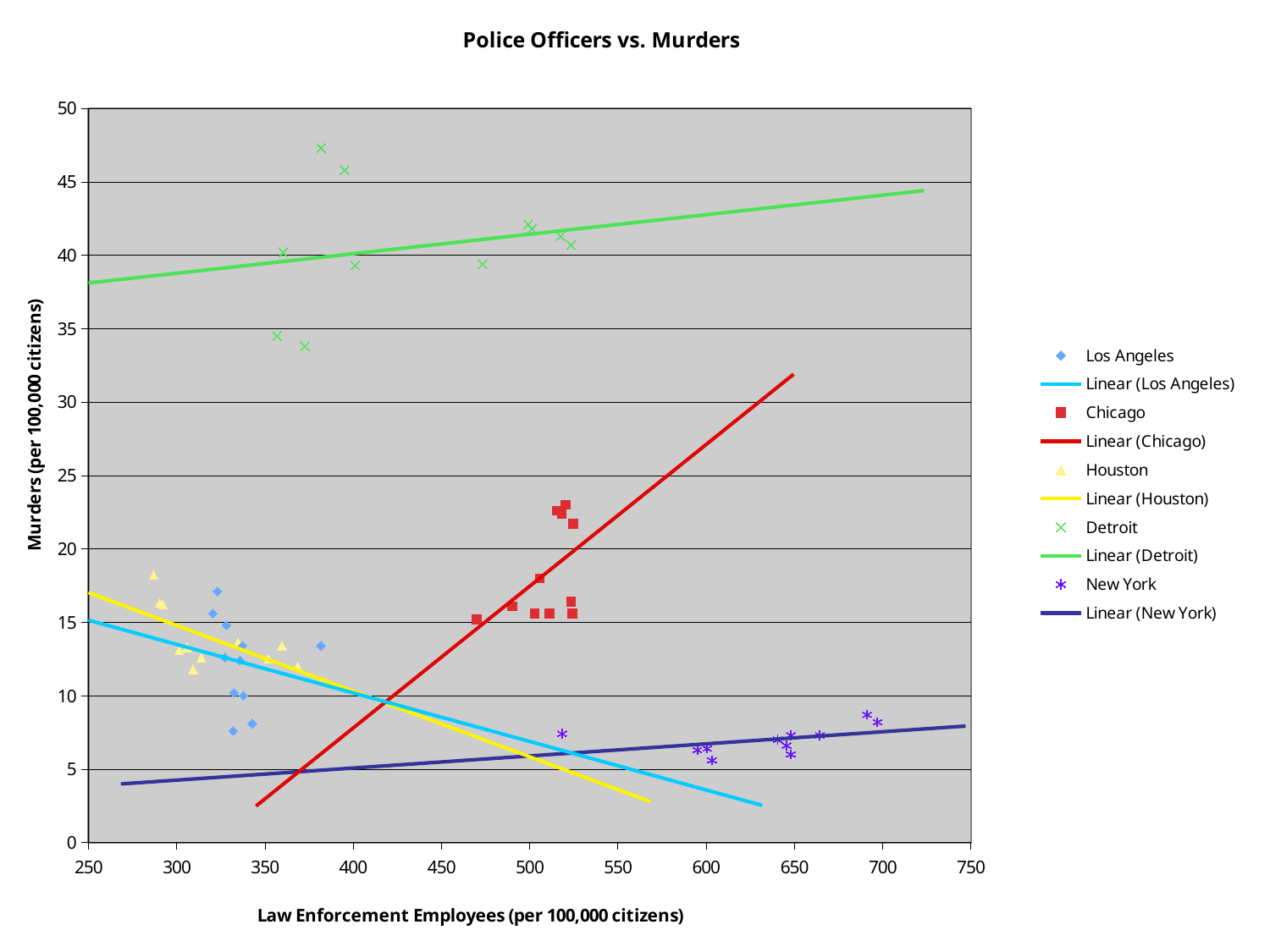
What kind of chart is shown on the slide? Scatter chart How many cities are plotted as data series in the chart? 5 Which city has more law enforcement employees per 100,000 citizens, New York or Houston? New York What is the label of the x axis? Law Enforcement Employees (per 100,000 citizens) Which city has the lowest murder rates in the chart? New York What is the title of the chart? Police Officers vs. Murders Does the Linear (Los Angeles) trend line rise or fall as law enforcement employees increase? fall Are the murder rates for New York greater or less than 10 per 100,000 citizens? less Which city has the highest murder rates in the chart? Detroit Are the murder rates for Detroit greater or less than 30 per 100,000 citizens? greater How many entries does the chart's legend list? 10 Does the Linear (Detroit) trend line rise or fall as law enforcement employees increase? rise